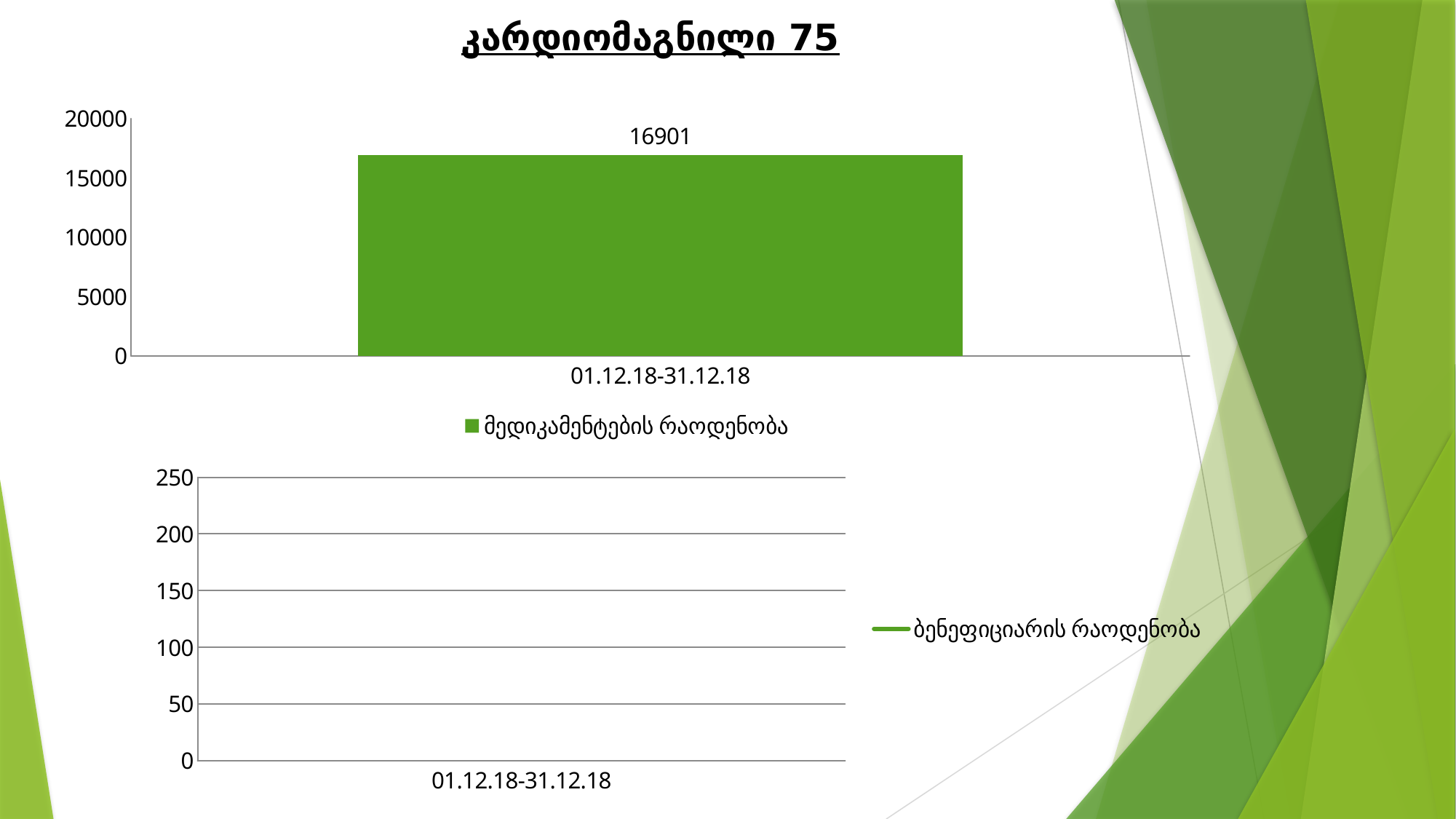
What category label appears on the x axis of the top chart? 01.12.18-31.12.18 In the top chart, is the value for 01.12.18-31.12.18 greater or less than 15000? greater What kind of chart is the top chart on the slide? bar chart How many bars are plotted in the top chart? 1 In the top chart, what is the value for 01.12.18-31.12.18? 16901 In the top chart, is the value for 01.12.18-31.12.18 greater or less than 20000? less What is the legend entry of the top chart? მედიკამენტების რაოდენობა How many series does the legend of the bottom chart list? 1 What is the highest value shown on the y axis of the bottom chart? 250 How many series does the legend of the top chart list? 1